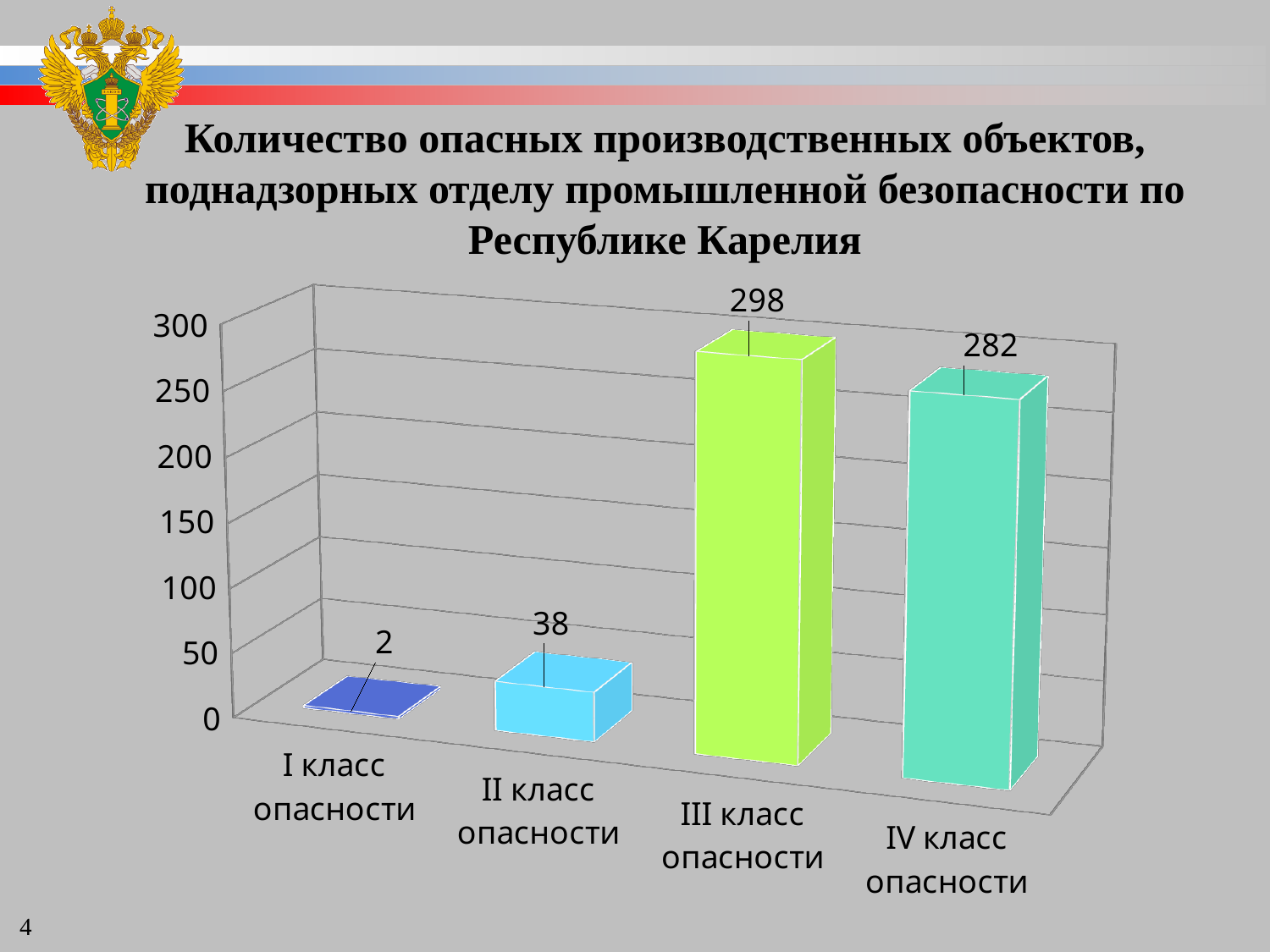
Which is larger, the value for II класс опасности or the value for IV класс опасности? IV класс опасности What is the value for II класс опасности? 38 What is the value for IV класс опасности? 282 What is the value for I класс опасности? 2 What is the title of the chart? Количество опасных производственных объектов, поднадзорных отделу промышленной безопасности по Республике Карелия What kind of chart is shown on the slide? bar chart How many categories are shown on the chart? 4 What is the difference between the values for II класс опасности and I класс опасности? 36 Which category has the lowest value? I класс опасности What is the value for III класс опасности? 298 Which category has the highest value? III класс опасности What is the difference between the values for III класс опасности and IV класс опасности? 16